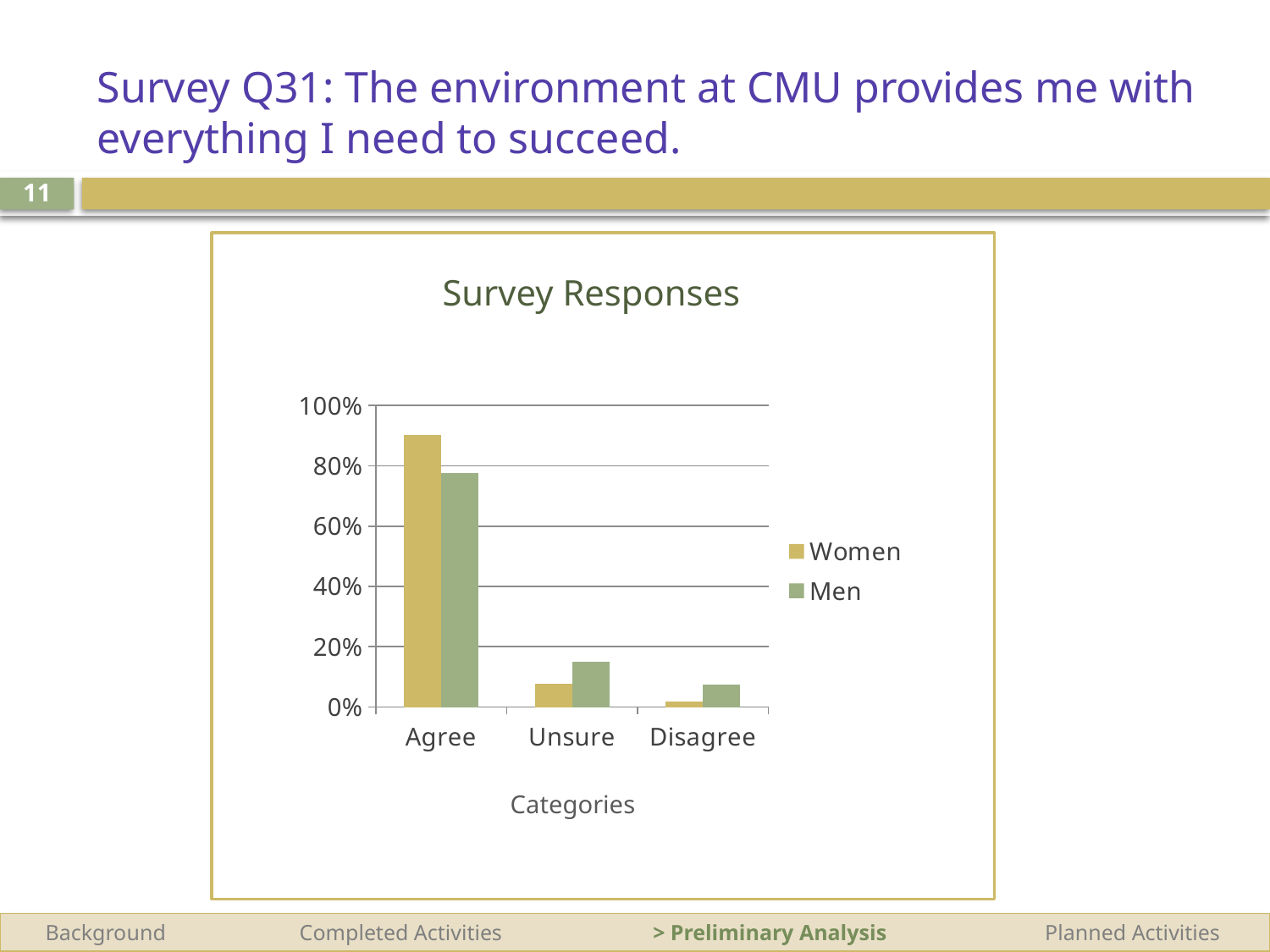
Is the value for Men in the Agree category greater or less than 60%? greater In the Agree category, which series has the larger value, Women or Men? Women How many series does the legend list? 2 What type of chart is shown on the slide? Bar chart What is the title of the chart? Survey Responses Which category has the highest value for Women? Agree Is the value for Women in the Disagree category greater or less than 20%? less Is the value for Men in the Unsure category greater or less than 20%? less How many categories are shown on the x axis? 3 Which category has the lowest value for Men? Disagree In the Unsure category, which series has the larger value, Women or Men? Men